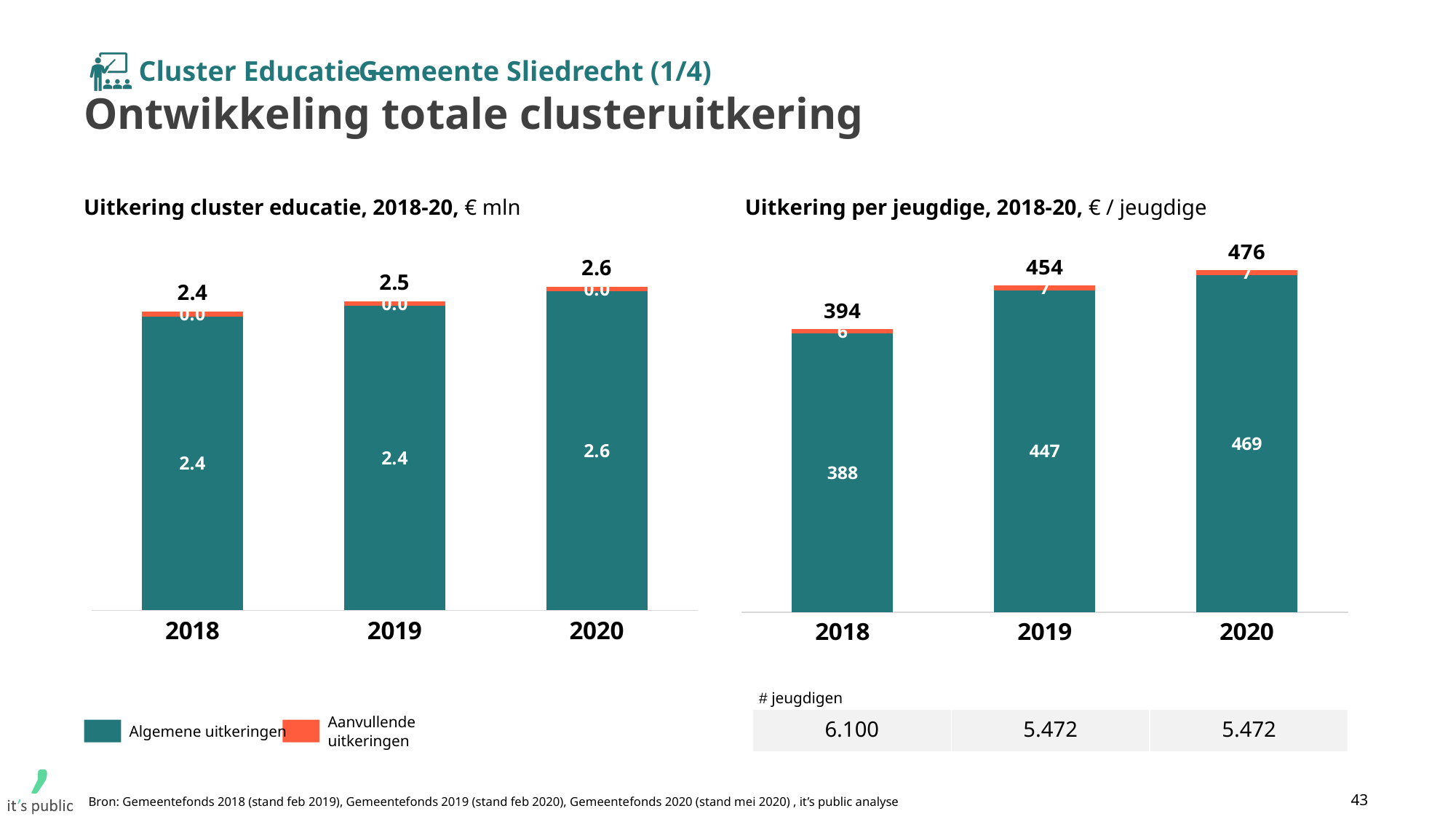
How many series does the legend on the slide list? 2 In the chart 'Uitkering per jeugdige, 2018-20', is the Algemene uitkeringen value for 2019 larger or smaller than for 2020? smaller How many years are shown on the x axis of the chart 'Uitkering cluster educatie, 2018-20'? 3 Do the total values in the chart 'Uitkering per jeugdige, 2018-20' rise or fall from 2018 to 2020? rise In the chart 'Uitkering per jeugdige, 2018-20', what is the total value labelled above the bar for 2020? 476 In the chart 'Uitkering per jeugdige, 2018-20', what is the difference between the total for 2020 and the total for 2018? 82 In the chart 'Uitkering cluster educatie, 2018-20', what is the total value labelled above the bar for 2019? 2.5 In the chart 'Uitkering per jeugdige, 2018-20', what is the value of the Aanvullende uitkeringen segment for 2019? 7 In the chart 'Uitkering per jeugdige, 2018-20', which year has the lowest total value? 2018 In the chart 'Uitkering per jeugdige, 2018-20', which year has the highest total value? 2020 In the chart 'Uitkering per jeugdige, 2018-20', what is the value of the Algemene uitkeringen segment for 2018? 388 In the chart 'Uitkering cluster educatie, 2018-20', what is the value of the Algemene uitkeringen segment for 2020? 2.6